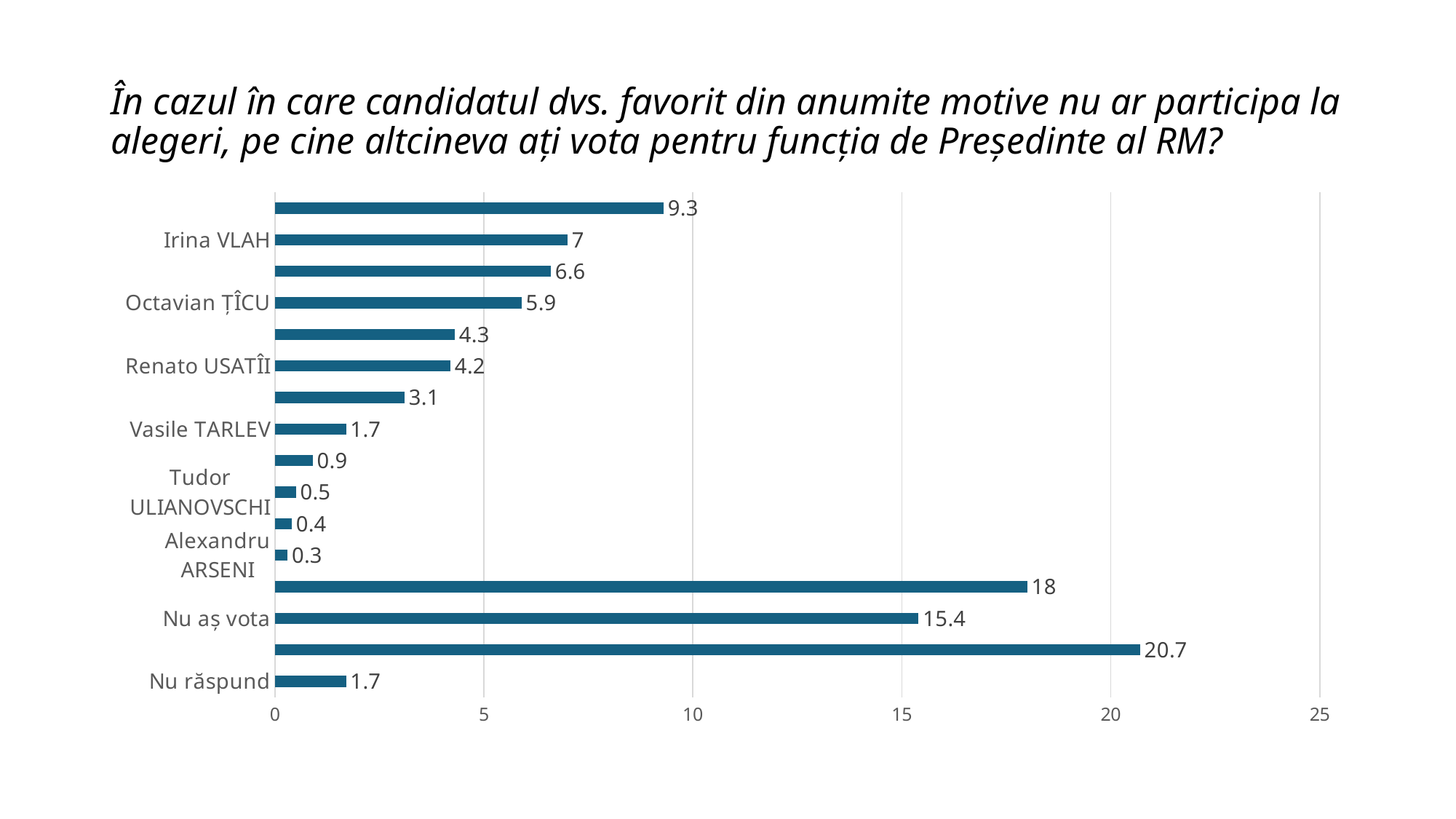
What is the value for Nu răspund? 1.7 What is the value for Octavian ȚÎCU? 5.9 What is the largest value printed on the chart? 20.7 Which category has the lowest value? Alexandru ARSENI Is the value for Nu aș vota greater or less than 10? greater What is the value for Renato USATÎI? 4.2 Which is larger, the value for Vasile TARLEV or the value for Tudor ULIANOVSCHI? Vasile TARLEV What is the value for Nu aș vota? 15.4 What is the value for Alexandru ARSENI? 0.3 What is the value for Irina VLAH? 7 How many bars are plotted on the chart? 16 What is the difference between the values for Irina VLAH and Octavian ȚÎCU? 1.1